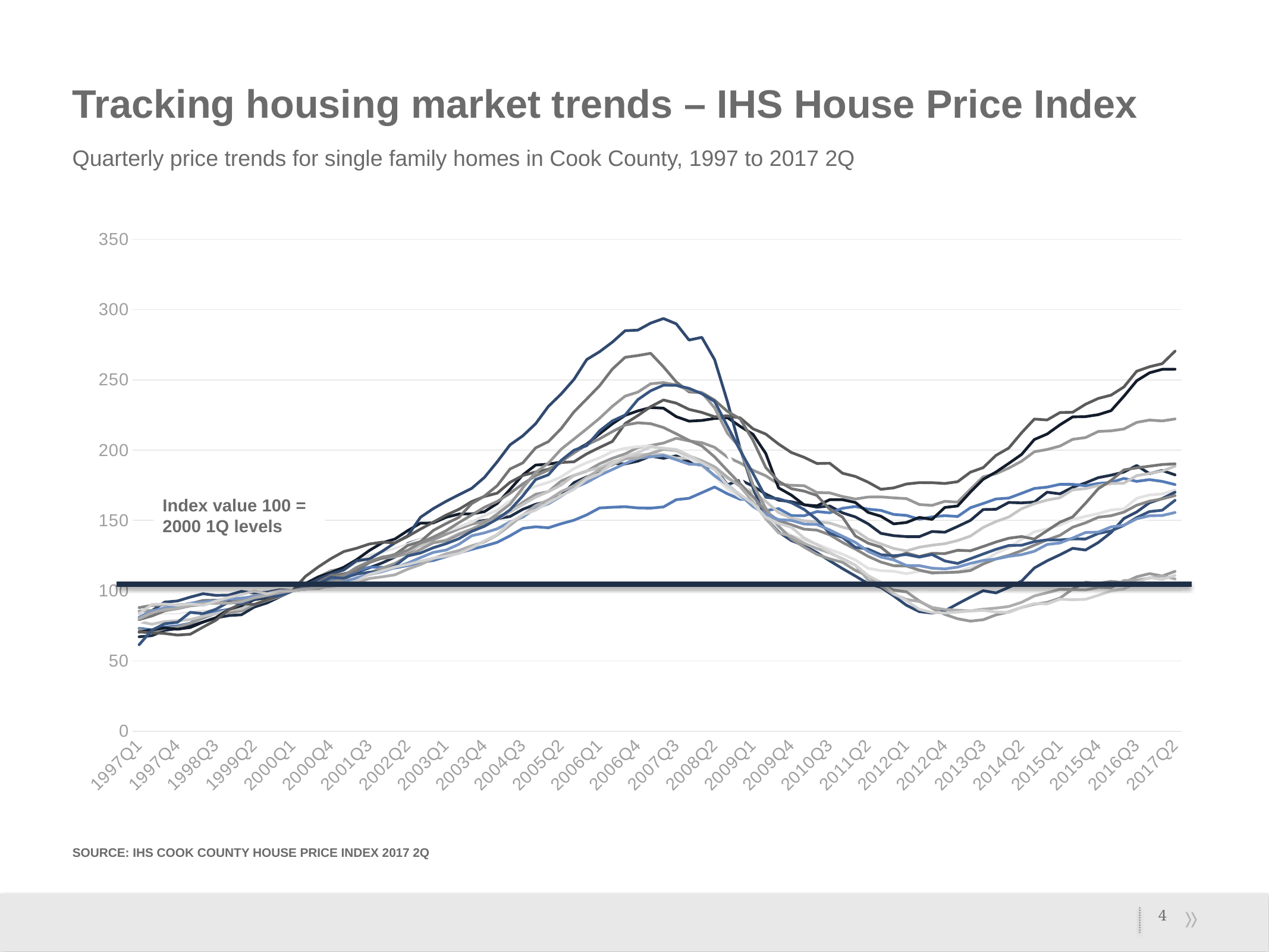
What is the first period labelled on the x axis? 1997Q1 Do the lines generally rise or fall between 2007Q3 and 2012Q1? fall What is the title of the slide's chart? Tracking housing market trends – IHS House Price Index According to the annotation on the chart, what does an index value of 100 represent? 2000 1Q levels Is the highest peak reached by any line greater or less than 250? greater At 1997Q1, are the lines greater or less than 100? less What kind of chart is shown on the slide? line chart Do the lines generally rise or fall between 2000Q1 and 2007Q3? rise What is the last period labelled on the x axis? 2017Q2 Is the highest peak reached by any line greater or less than 300? less How many period labels are printed along the x axis? 28 What is the highest value shown on the y axis? 350